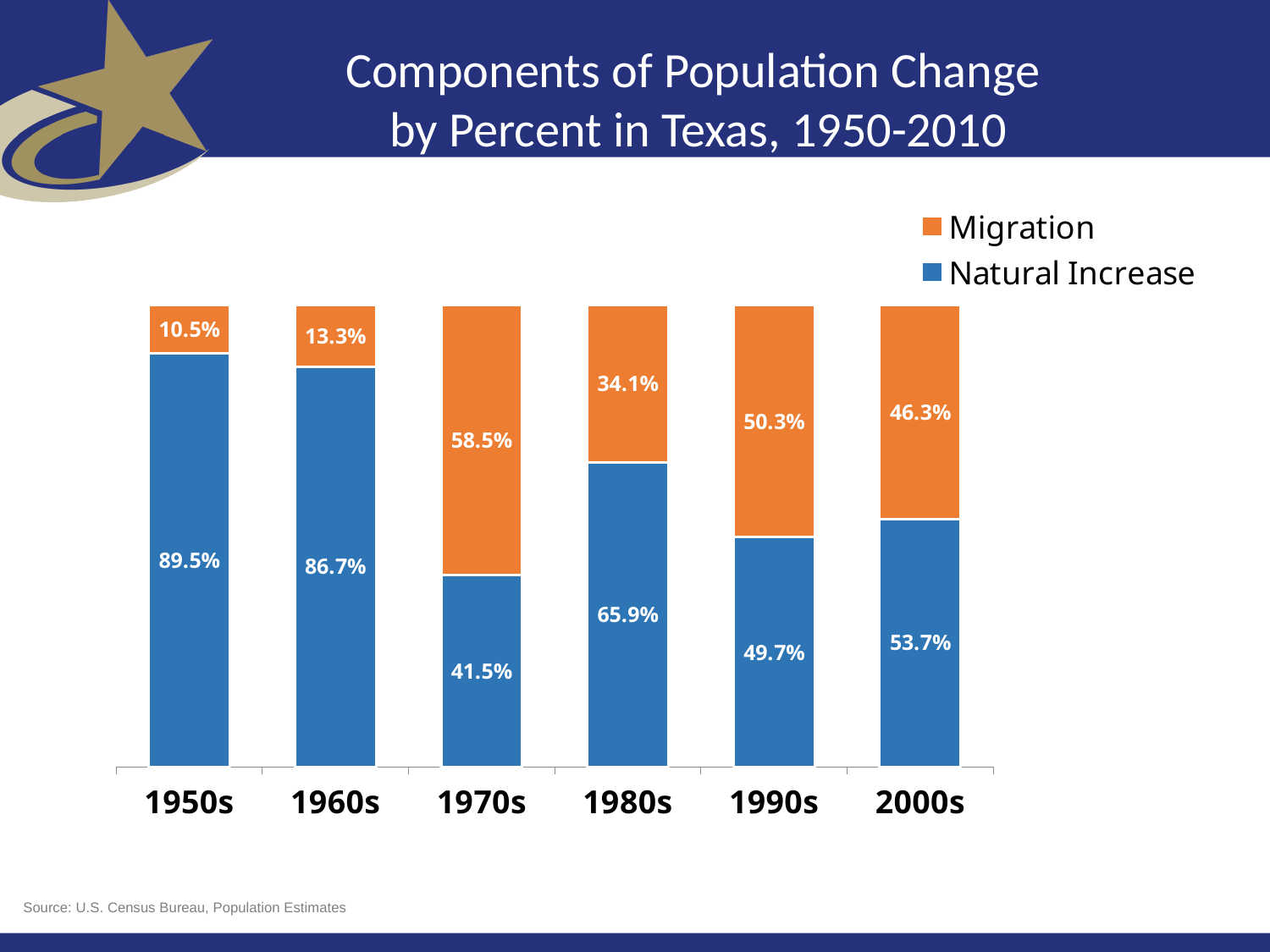
Does the Natural Increase value rise or fall from the 1950s to the 1970s? Fall What is the difference between the Natural Increase and Migration values in the 1980s? 31.8% How many decades are shown on the x axis? 6 What is the Migration value for the 2000s? 46.3% What kind of chart is shown on the slide? Stacked bar chart Which colour represents Migration in the chart? Orange What is the Migration value for the 1970s? 58.5% Which is larger in the 1990s, Migration or Natural Increase? Migration How many series does the legend list? 2 What is the Natural Increase value for the 1950s? 89.5% Which decade has the highest Migration value? 1970s Which decade has the lowest Natural Increase value? 1970s